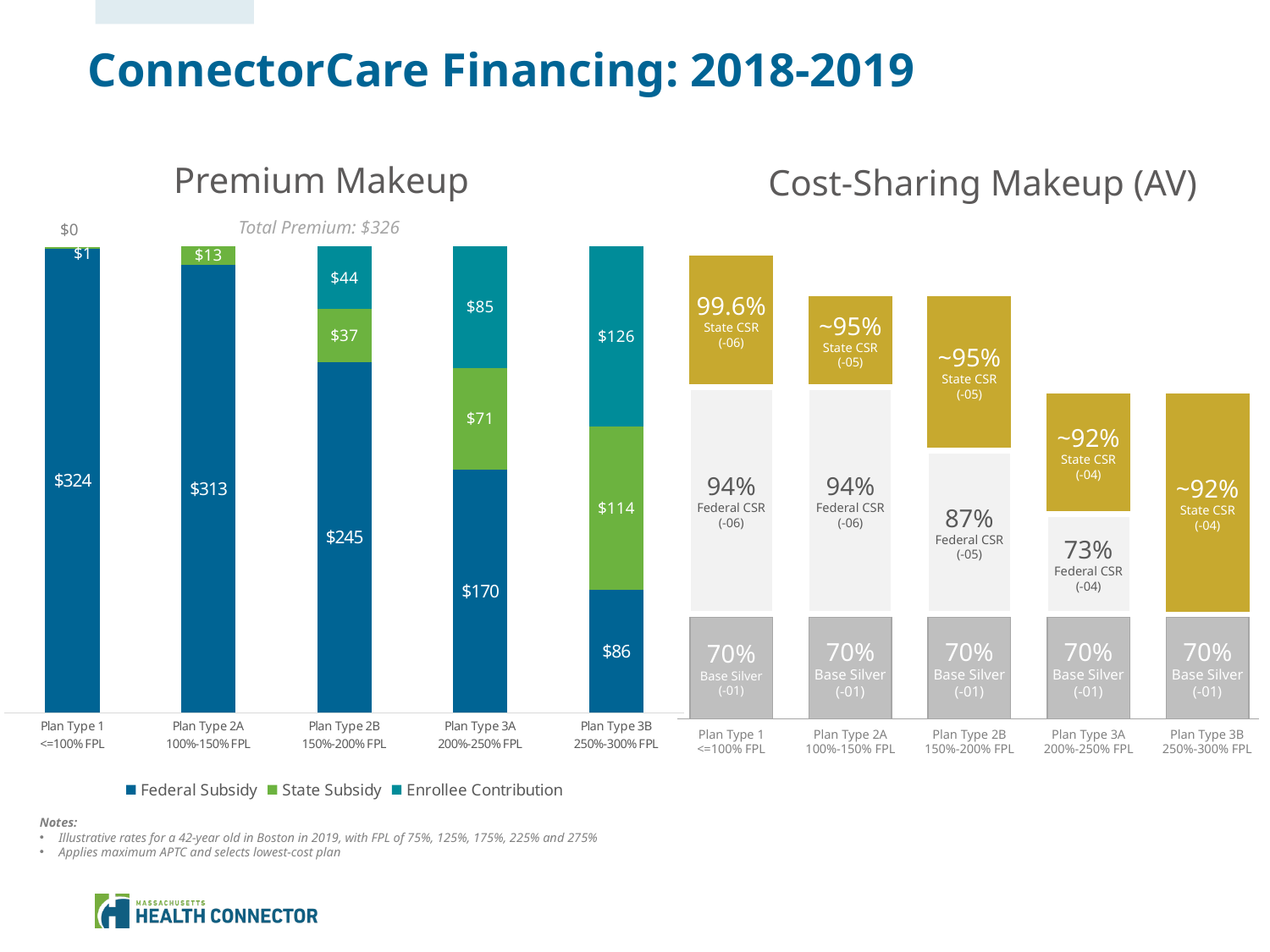
In the Cost-Sharing Makeup (AV) chart, what is the Federal CSR value for Plan Type 3A? 73% In the Premium Makeup chart, which plan type has the highest Federal Subsidy? Plan Type 1 In the Premium Makeup chart, what is the difference between the Federal Subsidy for Plan Type 2A and Plan Type 2B? $68 In the Cost-Sharing Makeup (AV) chart, what is the State CSR value for Plan Type 1? 99.6% In the Premium Makeup chart, what is the Enrollee Contribution for Plan Type 3B? $126 In the Premium Makeup chart, what is the State Subsidy for Plan Type 3A? $71 In the Premium Makeup chart, which is larger: the Enrollee Contribution for Plan Type 3A or for Plan Type 3B? Plan Type 3B In the Premium Makeup chart, what is the Federal Subsidy for Plan Type 2B? $245 How many plan types are shown on the x axis of the Premium Makeup chart? 5 How many series does the legend of the Premium Makeup chart list? 3 In the Premium Makeup chart, does the Federal Subsidy rise or fall from Plan Type 1 to Plan Type 3B? fall In the Premium Makeup chart, which plan type has the lowest Federal Subsidy? Plan Type 3B